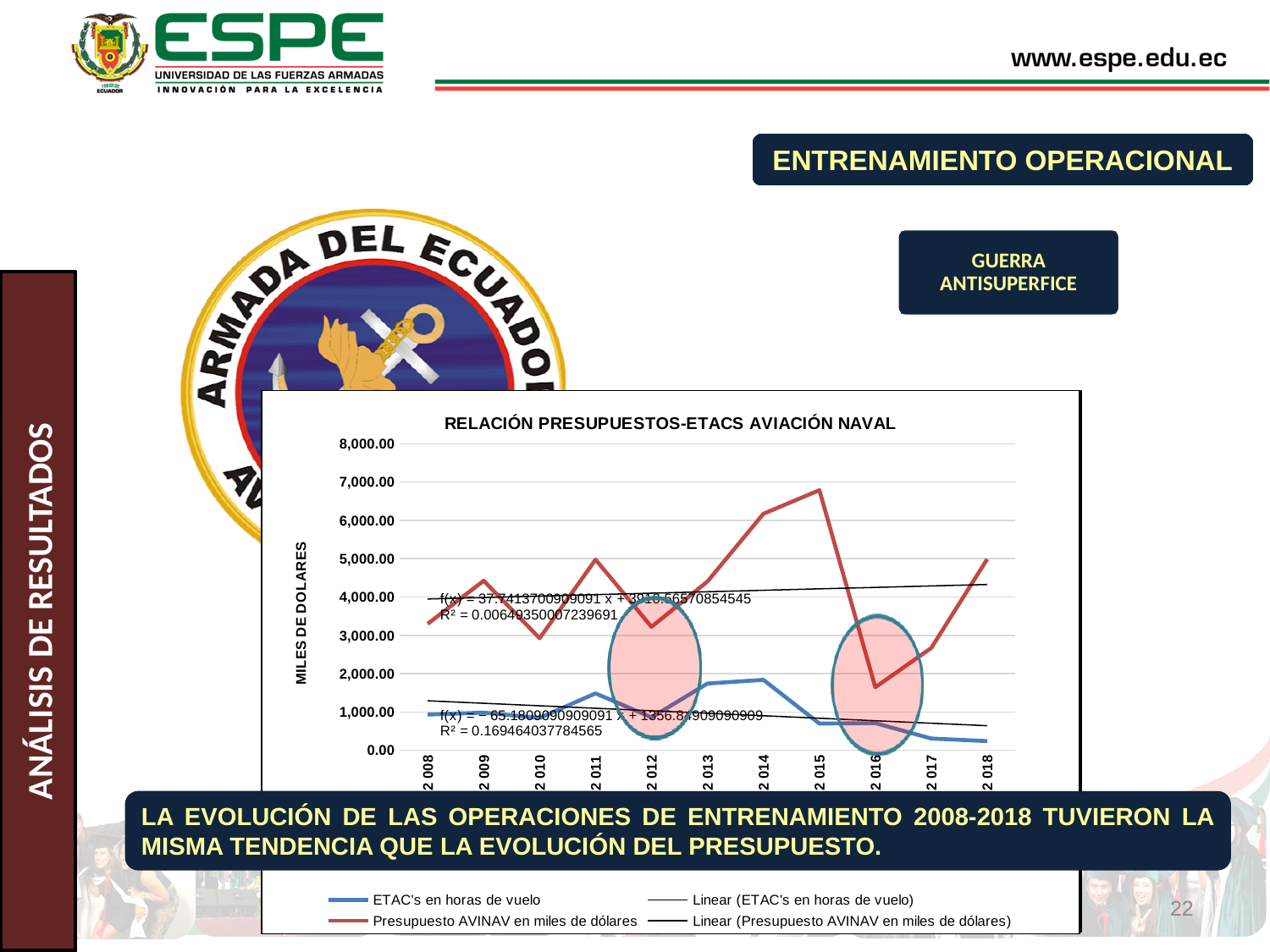
How many years are plotted along the x axis of the chart? 11 In which year does the Presupuesto AVINAV en miles de dólares series reach its highest value? 2015 Which is larger for ETAC's en horas de vuelo: the value in 2014 or the value in 2018? 2014 In which year does the Presupuesto AVINAV en miles de dólares series reach its lowest value? 2016 What is the title of the chart? RELACIÓN PRESUPUESTOS-ETACS AVIACIÓN NAVAL Is the ETAC's en horas de vuelo value for 2018 greater or less than 1,000.00? less Is the Presupuesto AVINAV en miles de dólares value for 2016 greater or less than 2,000.00? less Which is larger for Presupuesto AVINAV en miles de dólares: the value in 2014 or the value in 2016? 2014 Is the Presupuesto AVINAV en miles de dólares value for 2015 greater or less than 6,000.00? greater What type of chart is shown on the slide? Line chart How many entries does the chart legend list? 4 What is the label of the vertical axis of the chart? MILES DE DOLARES